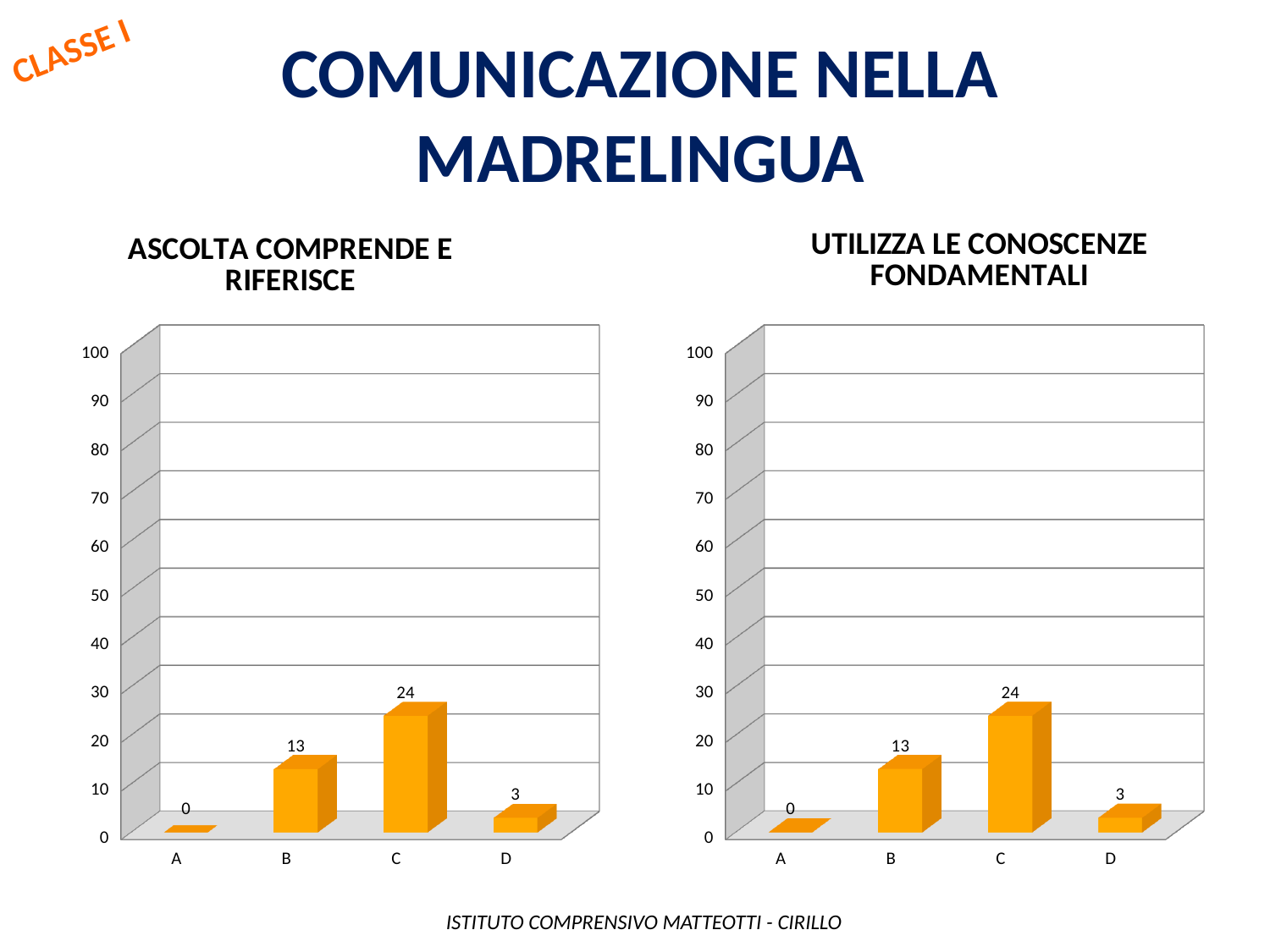
In the 'ASCOLTA COMPRENDE E RIFERISCE' chart, is the value for C greater or less than 20? greater In the 'UTILIZZA LE CONOSCENZE FONDAMENTALI' chart, what is the value for category D? 3 In the 'ASCOLTA COMPRENDE E RIFERISCE' chart, what is the value for category B? 13 What kind of chart is the 'ASCOLTA COMPRENDE E RIFERISCE' chart? Bar chart In the 'UTILIZZA LE CONOSCENZE FONDAMENTALI' chart, what is the value for category A? 0 In the 'UTILIZZA LE CONOSCENZE FONDAMENTALI' chart, which is larger, the value for B or the value for D? B In the 'ASCOLTA COMPRENDE E RIFERISCE' chart, what is the difference between the values for C and B? 11 In the 'ASCOLTA COMPRENDE E RIFERISCE' chart, which category has the highest value? C In the 'ASCOLTA COMPRENDE E RIFERISCE' chart, what is the value for category C? 24 What is the title of the chart on the right side of the slide? UTILIZZA LE CONOSCENZE FONDAMENTALI How many categories are shown in the 'UTILIZZA LE CONOSCENZE FONDAMENTALI' chart? 4 In the 'UTILIZZA LE CONOSCENZE FONDAMENTALI' chart, which category has the lowest value? A